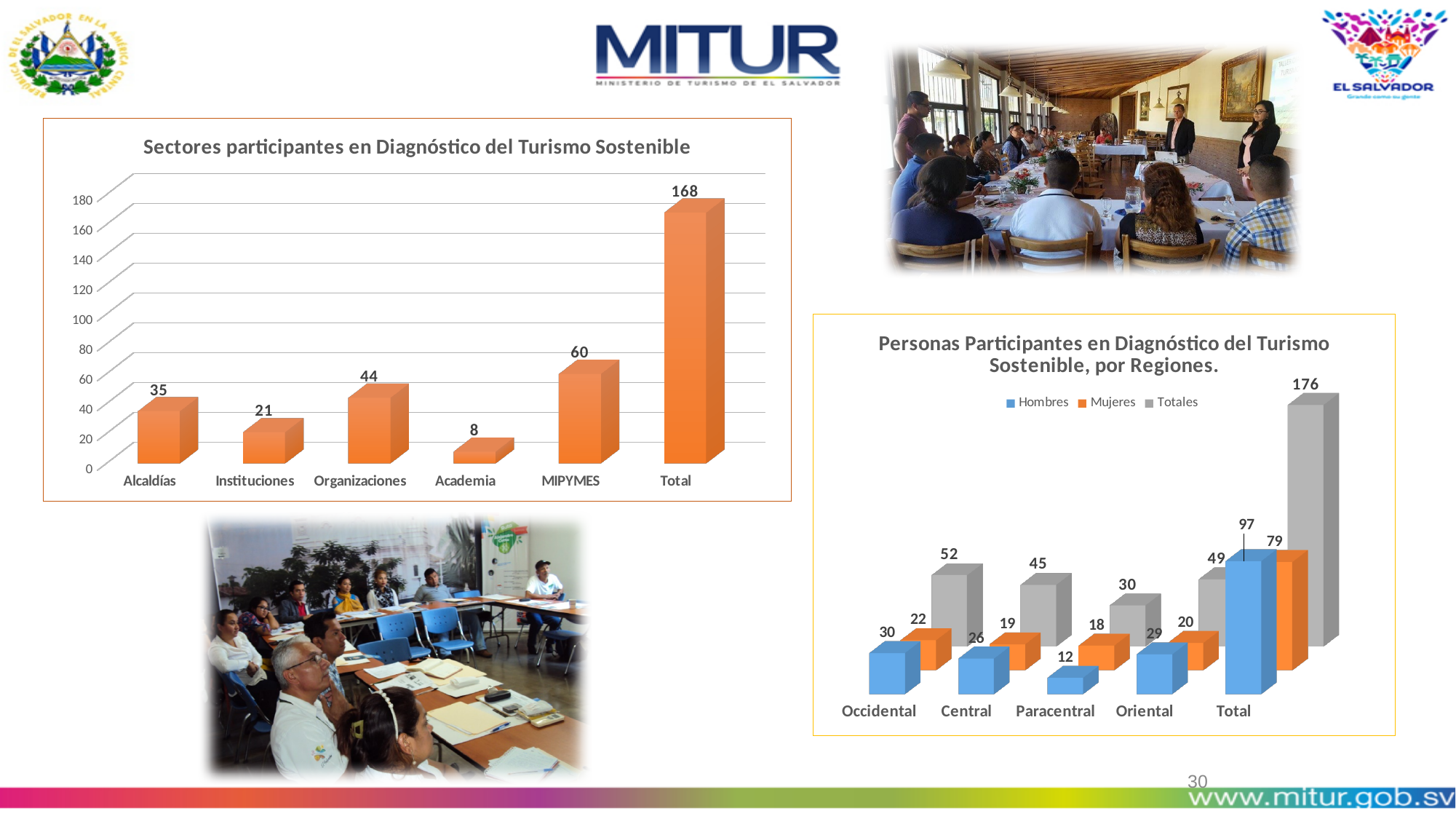
In the chart 'Personas Participantes en Diagnóstico del Turismo Sostenible, por Regiones.', what is the Mujeres value for Paracentral? 18 In the chart 'Personas Participantes en Diagnóstico del Turismo Sostenible, por Regiones.', is the Hombres value for Oriental larger or smaller than the Hombres value for Central? Larger In the chart 'Sectores participantes en Diagnóstico del Turismo Sostenible', which sector (excluding Total) has the highest value? MIPYMES In the chart 'Personas Participantes en Diagnóstico del Turismo Sostenible, por Regiones.', which region (excluding Total) has the highest Totales value? Occidental In the chart 'Personas Participantes en Diagnóstico del Turismo Sostenible, por Regiones.', how many series does the legend list? 3 In the chart 'Personas Participantes en Diagnóstico del Turismo Sostenible, por Regiones.', what colour represents the Mujeres series? Orange What kind of chart is 'Sectores participantes en Diagnóstico del Turismo Sostenible'? Bar chart In the chart 'Sectores participantes en Diagnóstico del Turismo Sostenible', which sector (excluding Total) has the lowest value? Academia In the chart 'Personas Participantes en Diagnóstico del Turismo Sostenible, por Regiones.', what is the difference between Hombres and Mujeres in the Total category? 18 In the chart 'Sectores participantes en Diagnóstico del Turismo Sostenible', what is the value for MIPYMES? 60 In the chart 'Sectores participantes en Diagnóstico del Turismo Sostenible', what is the difference between Organizaciones and Instituciones? 23 In the chart 'Sectores participantes en Diagnóstico del Turismo Sostenible', how many categories are shown on the x axis? 6